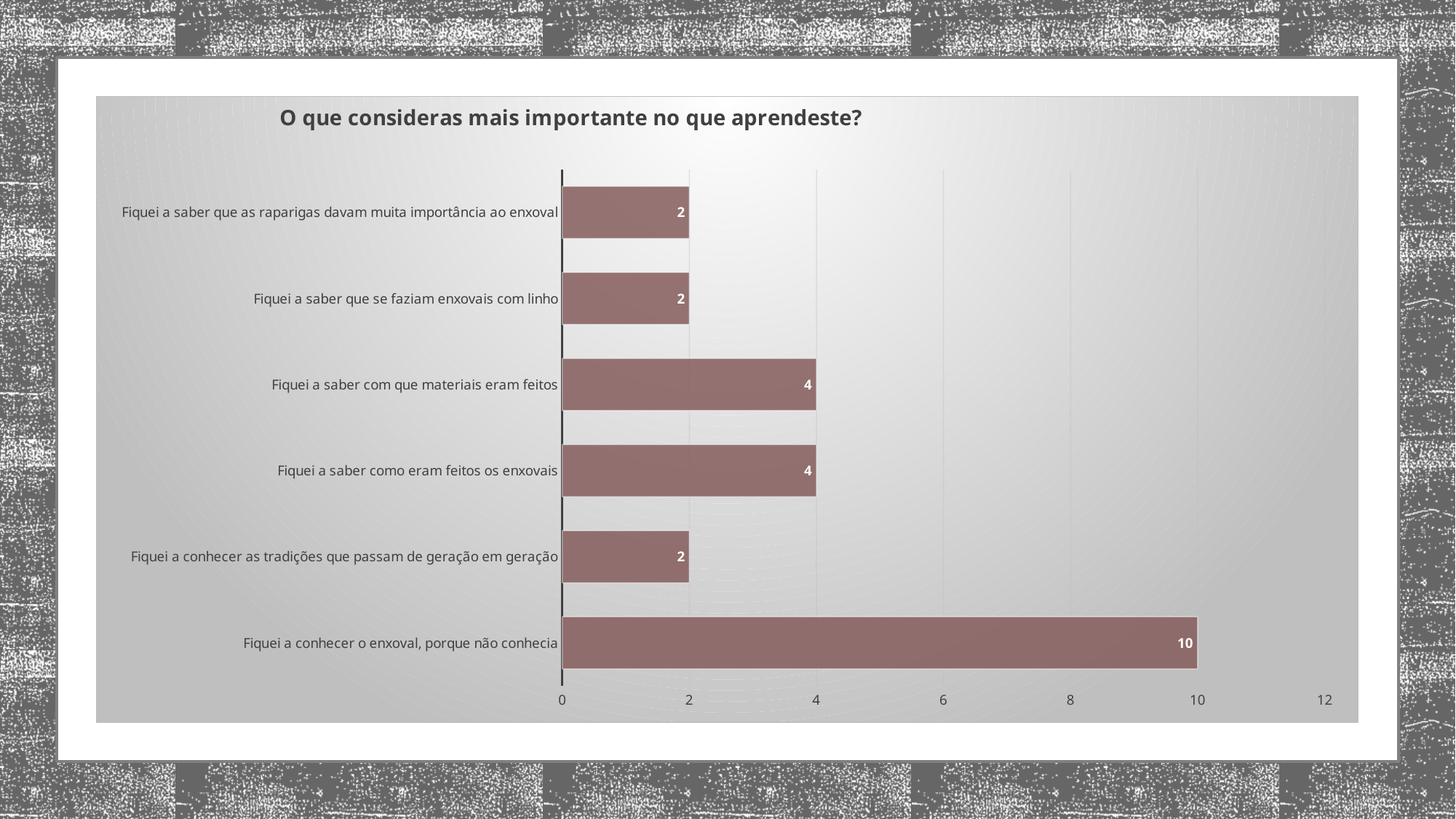
Which category has the highest value? Fiquei a conhecer o enxoval, porque não conhecia Which is larger: the value for "Fiquei a saber como eram feitos os enxovais" or the value for "Fiquei a saber que as raparigas davam muita importância ao enxoval"? Fiquei a saber como eram feitos os enxovais What is the value for "Fiquei a conhecer o enxoval, porque não conhecia"? 10 What is the value for "Fiquei a saber que se faziam enxovais com linho"? 2 What is the title of the chart? O que consideras mais importante no que aprendeste? Is the value for "Fiquei a conhecer o enxoval, porque não conhecia" greater or less than 8? greater What is the difference between the values for "Fiquei a conhecer o enxoval, porque não conhecia" and "Fiquei a saber como eram feitos os enxovais"? 6 What kind of chart is shown on the slide? Bar chart What is the value for "Fiquei a conhecer as tradições que passam de geração em geração"? 2 What is the highest value shown on the horizontal axis? 12 What is the value for "Fiquei a saber com que materiais eram feitos"? 4 How many categories are shown in the chart? 6